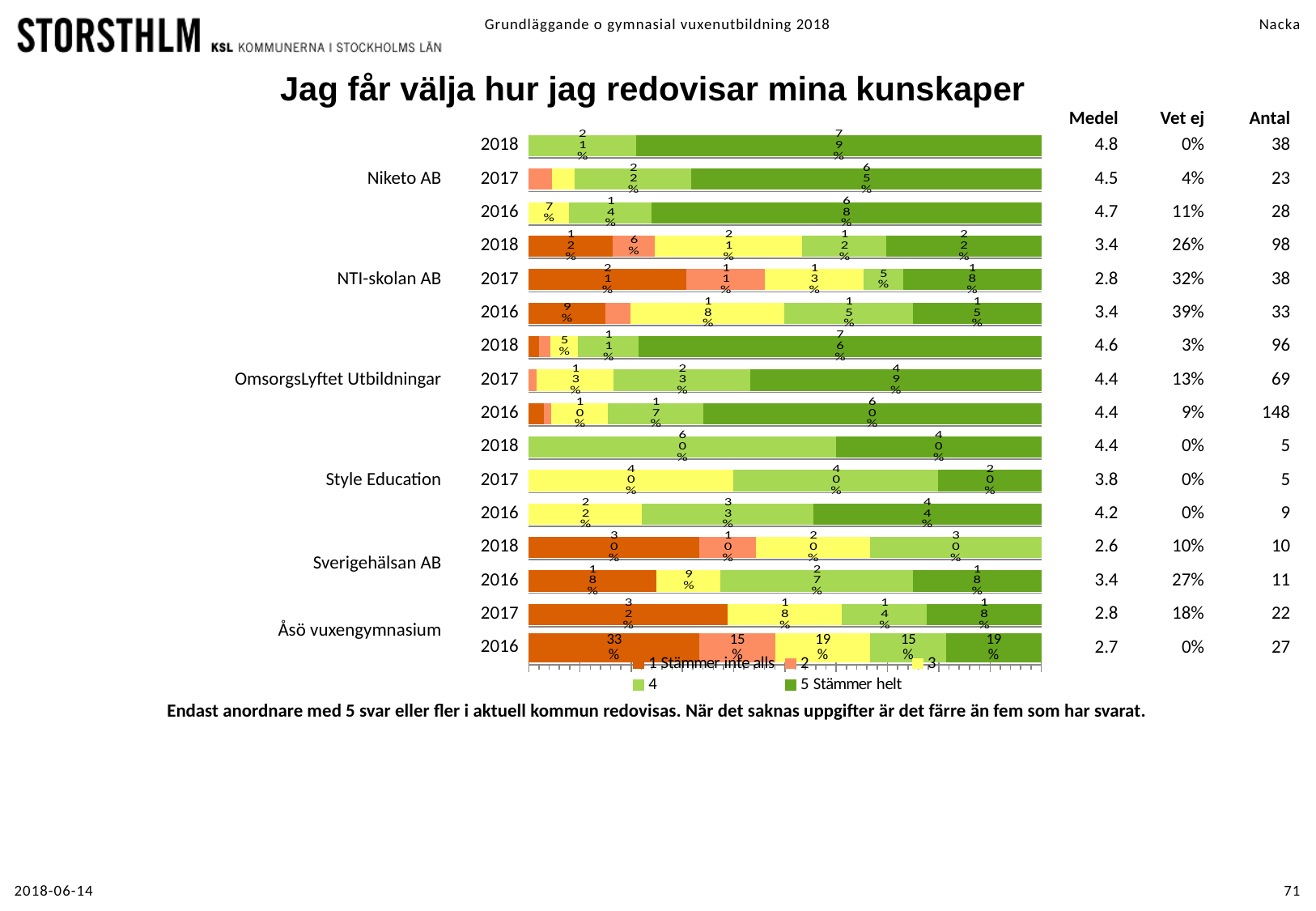
What is the Antal for OmsorgsLyftet Utbildningar in 2016? 148 What is the Medel value for Niketo AB in 2018? 4.8 What percentage of Style Education respondents in 2018 answered '4'? 60% What kind of chart is shown on the slide? Stacked bar chart How many providers (anordnare) are listed on the chart? 6 How many series does the legend list? 5 What percentage of Niketo AB respondents in 2018 answered '5 Stämmer helt'? 79% What percentage of Åsö vuxengymnasium respondents in 2016 answered '5 Stämmer helt'? 19% For Style Education in 2016, what is the difference between the share answering '5 Stämmer helt' and the share answering '3'? 22 percentage points Which provider and year has the lowest Medel value? Sverigehälsan AB 2018 What percentage of Åsö vuxengymnasium respondents in 2016 answered '1 Stämmer inte alls'? 33% For Niketo AB in 2018, which is larger: the share answering '4' or the share answering '5 Stämmer helt'? 5 Stämmer helt